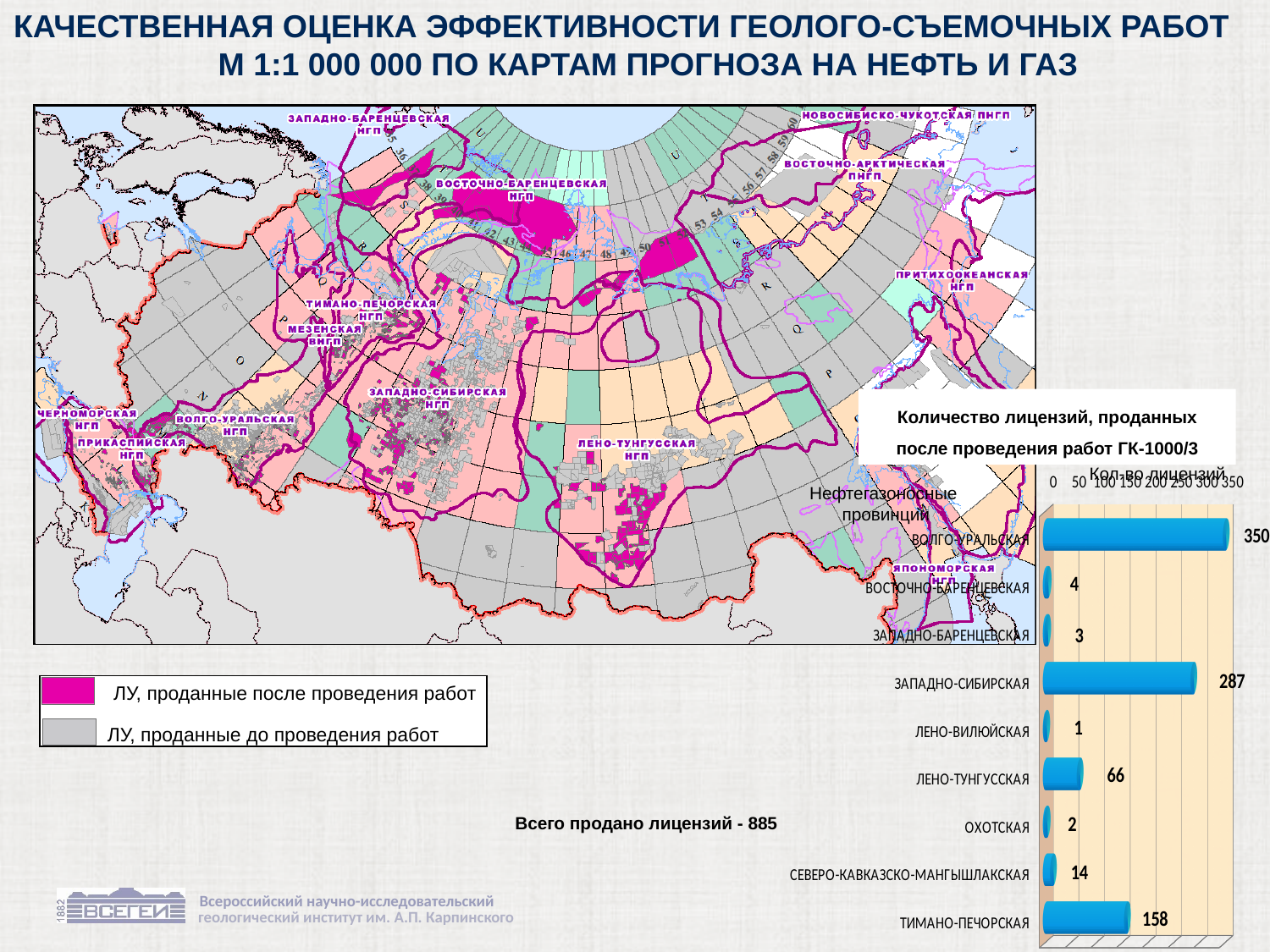
In the bar chart, which is larger: the value for ТИМАНО-ПЕЧОРСКАЯ or for ЛЕНО-ТУНГУССКАЯ? ТИМАНО-ПЕЧОРСКАЯ In the bar chart, what is the value for СЕВЕРО-КАВКАЗСКО-МАНГЫШЛАКСКАЯ? 14 In the bar chart, what is the difference between the values for ВОЛГО-УРАЛЬСКАЯ and ЗАПАДНО-СИБИРСКАЯ? 63 In the bar chart, how many licenses were sold for ВОЛГО-УРАЛЬСКАЯ? 350 What type of chart is shown on the right side of the slide? bar chart Which province has the lowest number of licenses in the bar chart? ЛЕНО-ВИЛЮЙСКАЯ In the bar chart, what is the value for ЛЕНО-ТУНГУССКАЯ? 66 What is the title of the bar chart? Количество лицензий, проданных после проведения работ ГК-1000/3 In the bar chart, what is the value for ЗАПАДНО-СИБИРСКАЯ? 287 How many provinces (categories) are shown in the bar chart? 9 In the bar chart, what is the value for ТИМАНО-ПЕЧОРСКАЯ? 158 Which province has the highest number of licenses in the bar chart? ВОЛГО-УРАЛЬСКАЯ